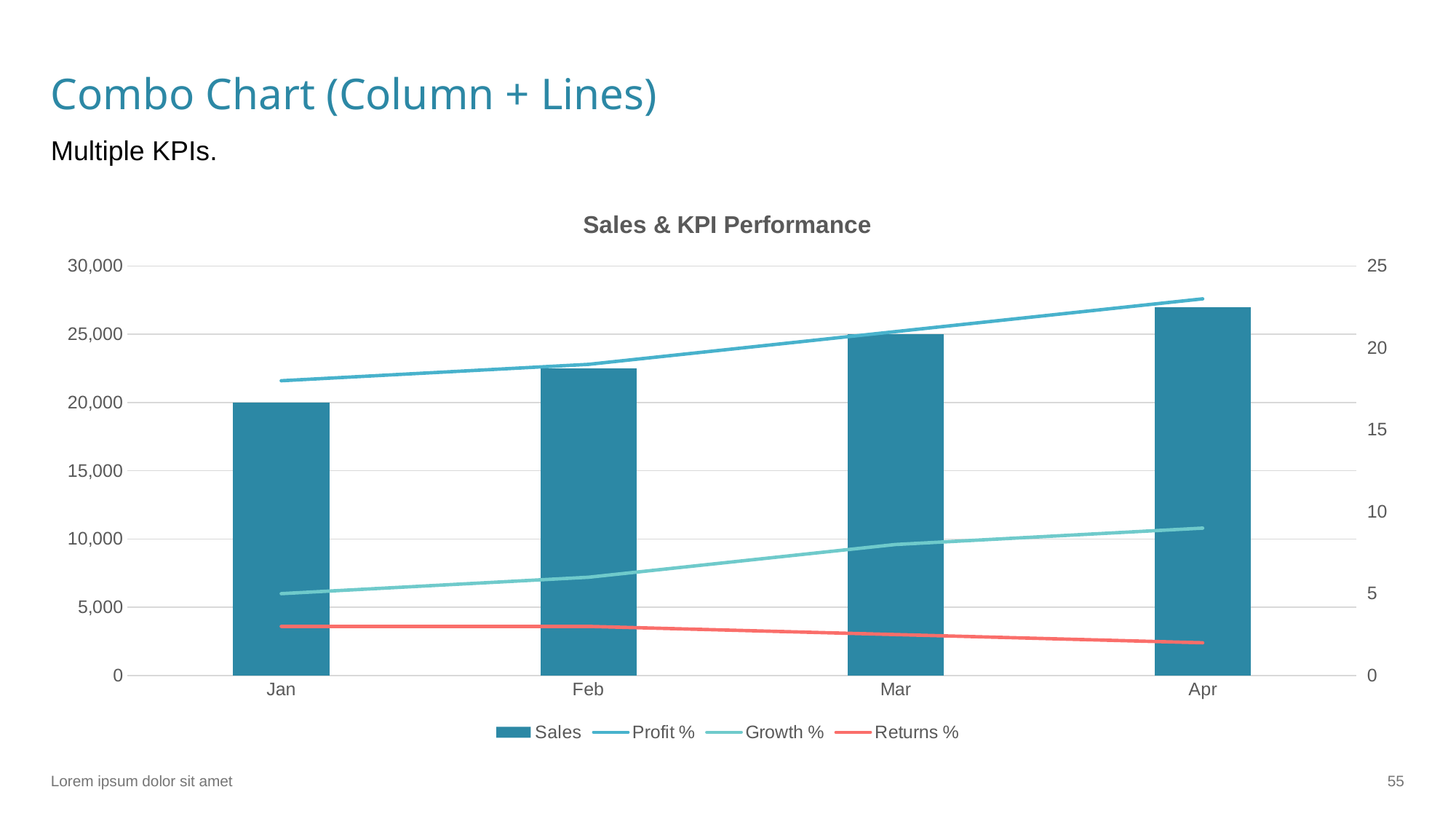
What is the Sales value for Mar? 25,000 Is the Sales value for Apr greater or less than 25,000? greater What kind of chart is shown on the slide? combo chart (bars and lines) How many series does the legend list? 4 What is the Sales value for Jan? 20,000 Which month has the lowest Sales? Jan Which month has the highest Sales? Apr What is the difference between Sales in Mar and Sales in Jan? 5,000 Does the Returns % line rise or fall from Jan to Apr? falls What is the title of the chart? Sales & KPI Performance Does the Profit % line rise or fall from Jan to Apr? rises How many months are shown on the x axis? 4